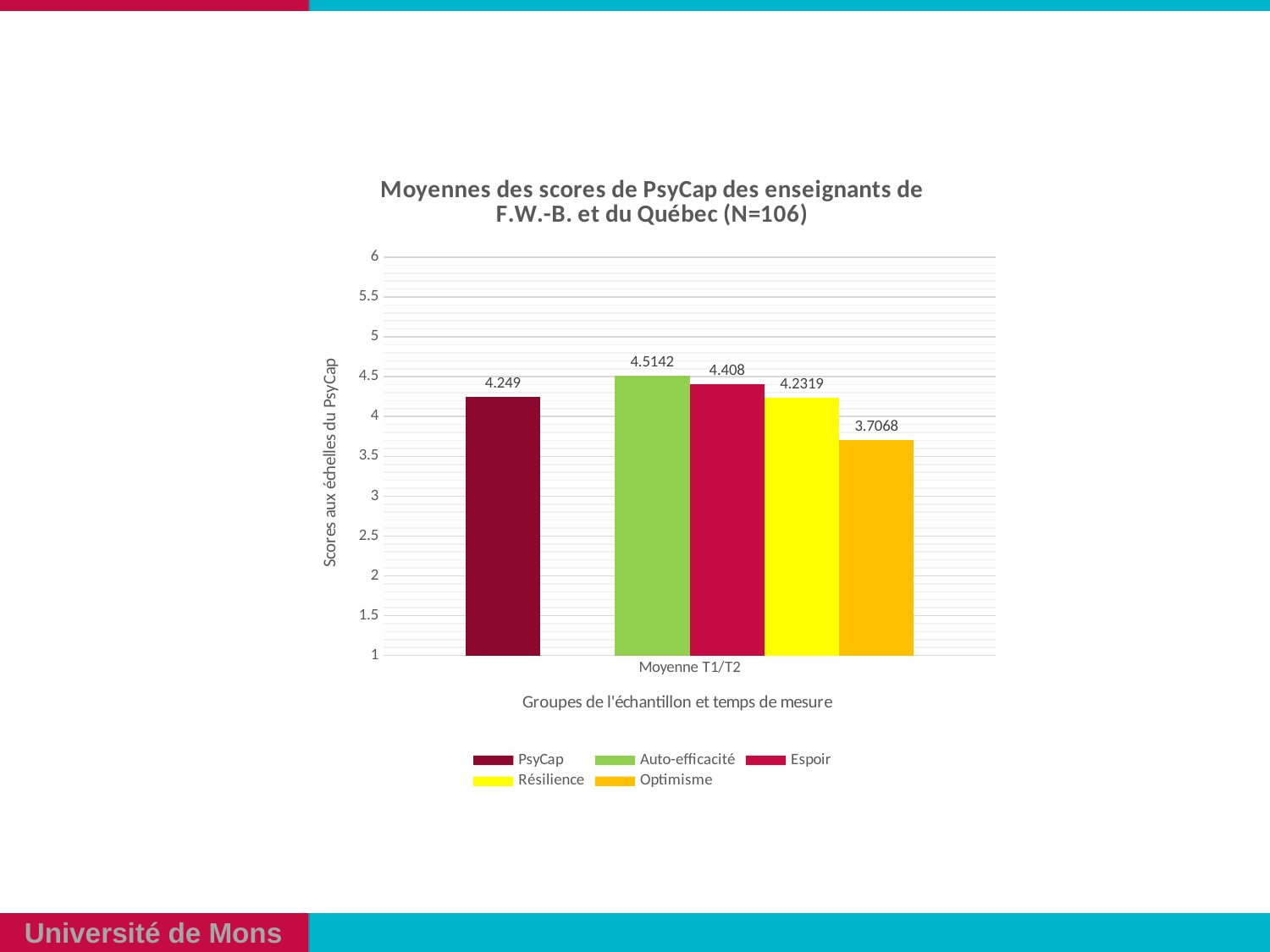
Is the value for Optimisme greater or less than 4? less Which series has the lowest value? Optimisme Which is larger, the value for Espoir or the value for Résilience? Espoir What is the value for Auto-efficacité? 4.5142 What is the value for Résilience? 4.2319 What kind of chart is shown? bar chart What is the value for Espoir? 4.408 What is the difference between the values for Auto-efficacité and Optimisme? 0.8074 Which series has the highest value? Auto-efficacité How many series does the legend list? 5 What is the value for Optimisme? 3.7068 What is the value for PsyCap? 4.249